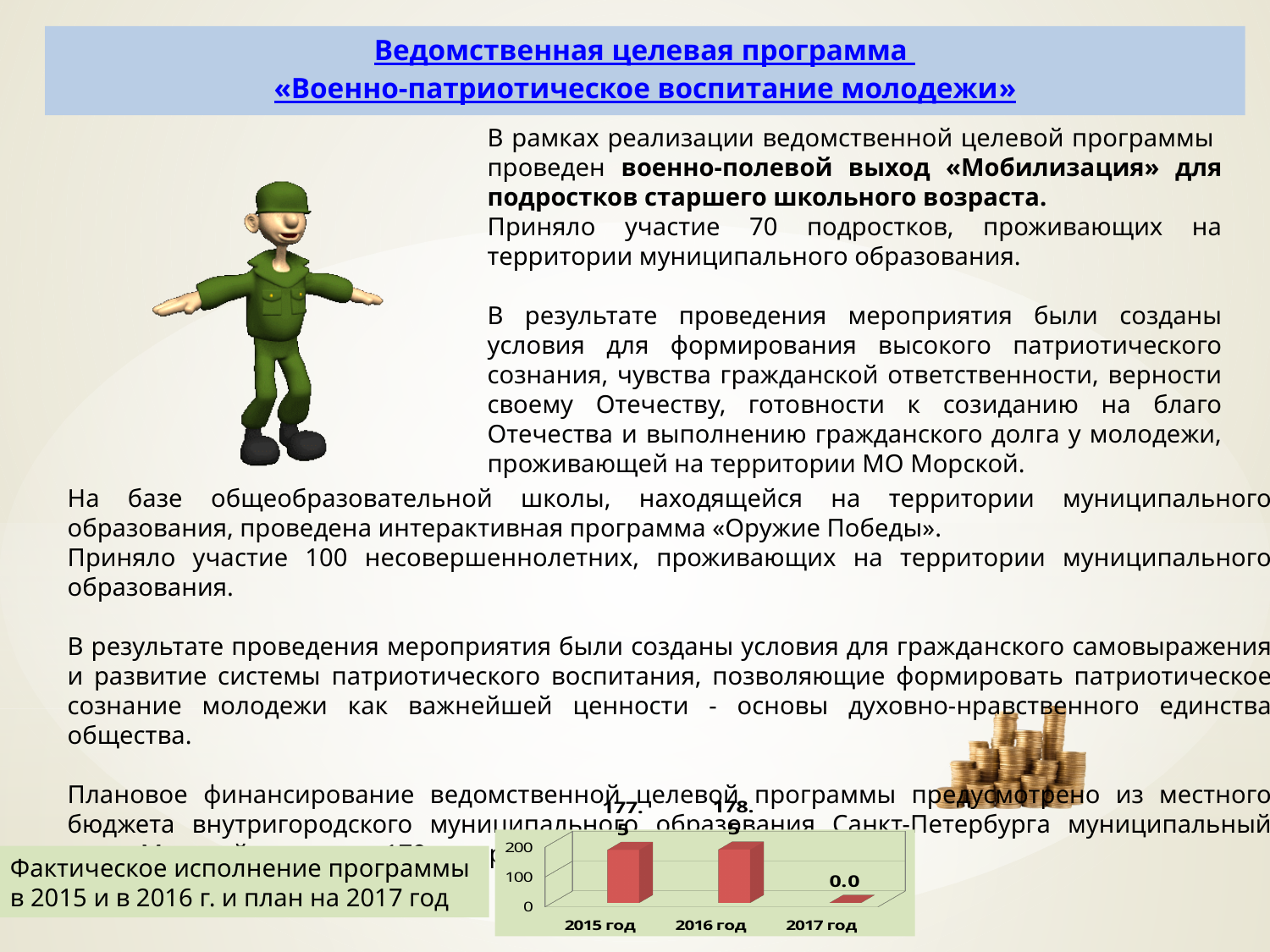
What kind of chart is shown at the bottom of the slide? bar chart Is the value for 2016 год greater or less than 100? greater What is the first category label on the x axis of the chart? 2015 год Is the value for 2015 год greater or less than 200? less What is the value shown for 2017 год in the chart? 0.0 Which year has the lowest value in the chart? 2017 год Is the value for 2015 год greater or less than 100? greater How many categories (years) are shown on the x axis of the chart? 3 What is the highest tick value shown on the vertical axis of the chart? 200 Which is larger, the value for 2016 год or the value for 2017 год? 2016 год